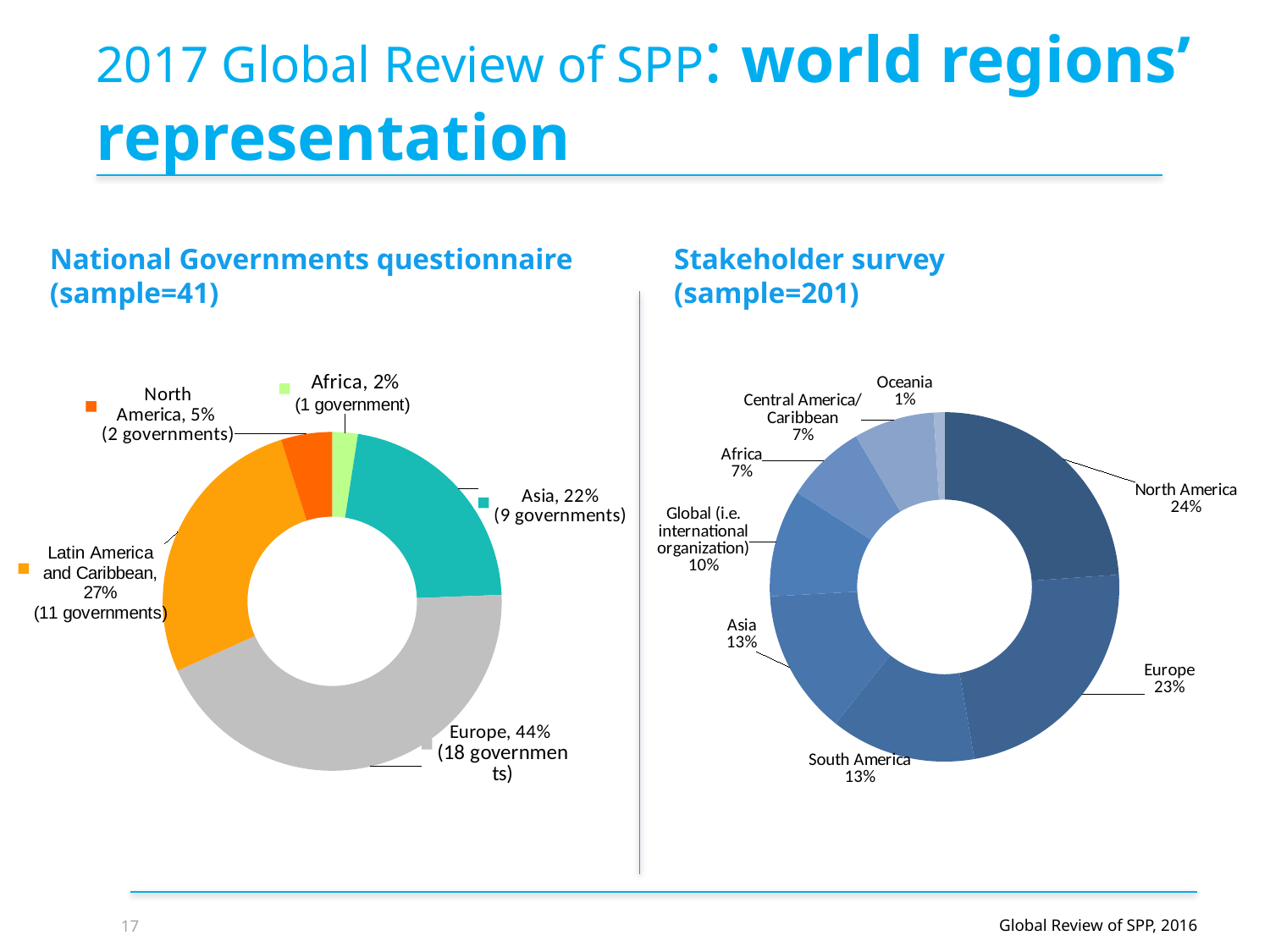
In the National Governments questionnaire chart, which region has the largest share? Europe In the National Governments questionnaire chart, which region has the smallest share? Africa In the National Governments questionnaire chart, how many governments does Asia represent? 9 governments In the National Governments questionnaire chart, what is the difference in percentage points between Latin America and Caribbean and North America? 22 In the Stakeholder survey chart, which is larger, Europe or Asia? Europe In the Stakeholder survey chart, what share does Global (i.e. international organization) have? 10% In the Stakeholder survey chart, how many categories are shown? 8 In the Stakeholder survey chart, what share does North America have? 24% In the Stakeholder survey chart, which region has the smallest share? Oceania In the National Governments questionnaire chart, how many regions are shown? 5 In the National Governments questionnaire chart, what share does Europe have? 44% What type of chart is used on the slide for the Stakeholder survey? Doughnut (pie) chart